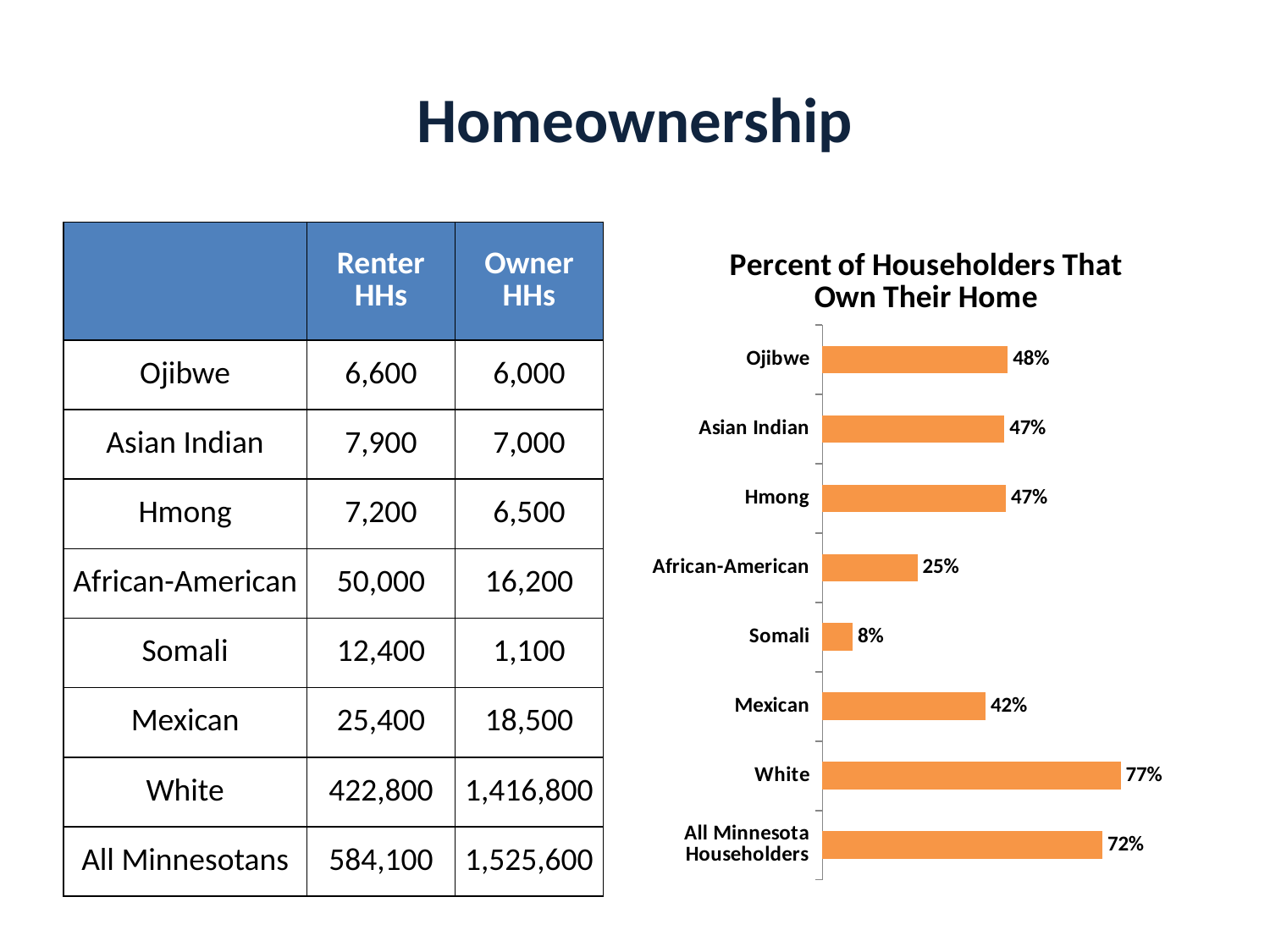
What is the percent of householders that own their home for All Minnesota Householders? 72% What is the difference in homeownership percent between White and African-American householders? 52% What kind of chart is shown on the slide? Bar chart How many categories are shown in the chart? 8 Which category has the lowest percent of householders that own their home? Somali Which has a higher homeownership percent, African-American or Mexican? Mexican What is the percent of householders that own their home for Somali? 8% What is the percent of householders that own their home for Mexican? 42% What is the title of the chart? Percent of Householders That Own Their Home Which category has the highest percent of householders that own their home? White What is the difference in homeownership percent between Ojibwe and Mexican householders? 6% What is the percent of householders that own their home for Ojibwe? 48%